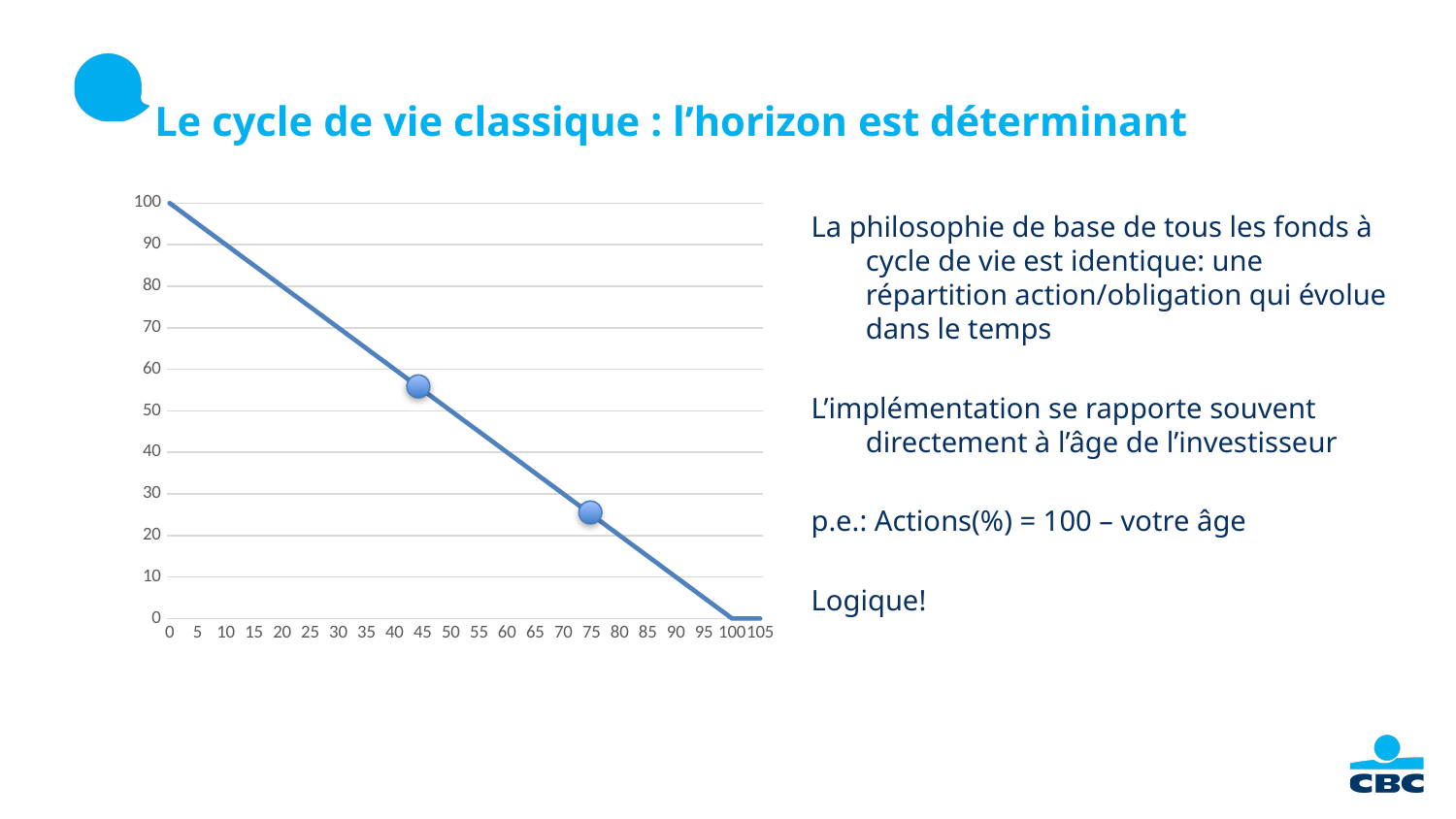
Is the value of the line at x = 45 greater or less than 50? greater What kind of chart is shown on the slide? line chart What is the value of the line at x = 100? 0 What is the highest value shown on the vertical axis? 100 What is the value of the line at x = 0? 100 Is the value of the line at x = 75 greater or less than 30? less Is the value of the line at x = 75 greater or less than 20? greater How many circular markers are highlighted on the line? 2 Which is larger, the value of the line at x = 45 or at x = 75? x = 45 Does the plotted line rise or fall as the x-axis value increases from 0 to 100? fall What is the title of the slide containing the chart? Le cycle de vie classique : l'horizon est déterminant